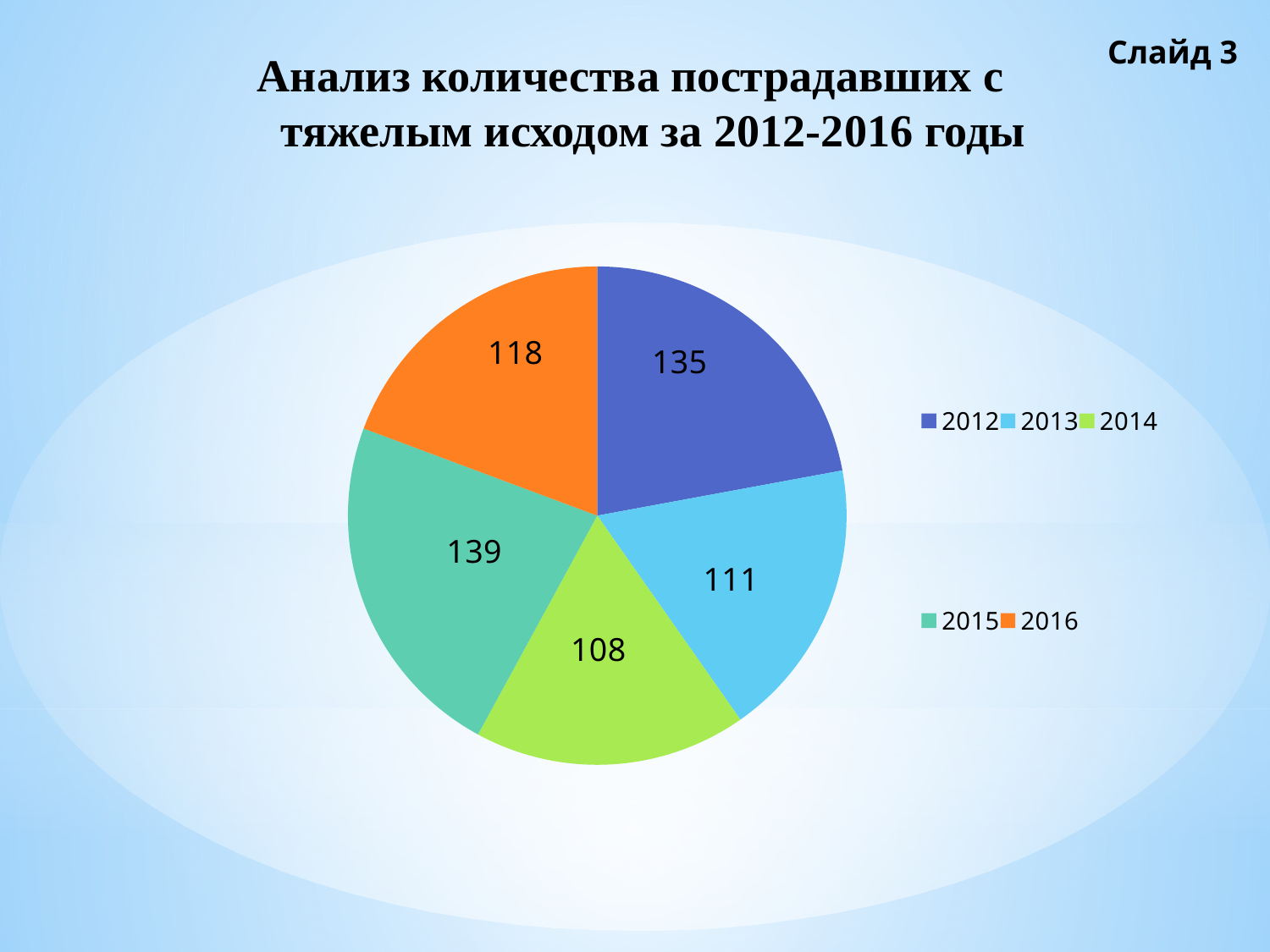
Which is larger, the value for 2016 or the value for 2013? 2016 What is the total of all the values shown in the pie chart? 611 What value is shown for 2012 in the pie chart? 135 What is the difference between the values for 2015 and 2014? 31 What value is shown for 2014 in the pie chart? 108 Which year has the largest slice in the pie chart? 2015 What value is shown for 2016 in the pie chart? 118 What is the difference between the values for 2012 and 2013? 24 What type of chart is shown on the slide? pie chart What colour is the slice for 2016 in the pie chart? orange Which year has the smallest slice in the pie chart? 2014 How many slices does the pie chart have? 5